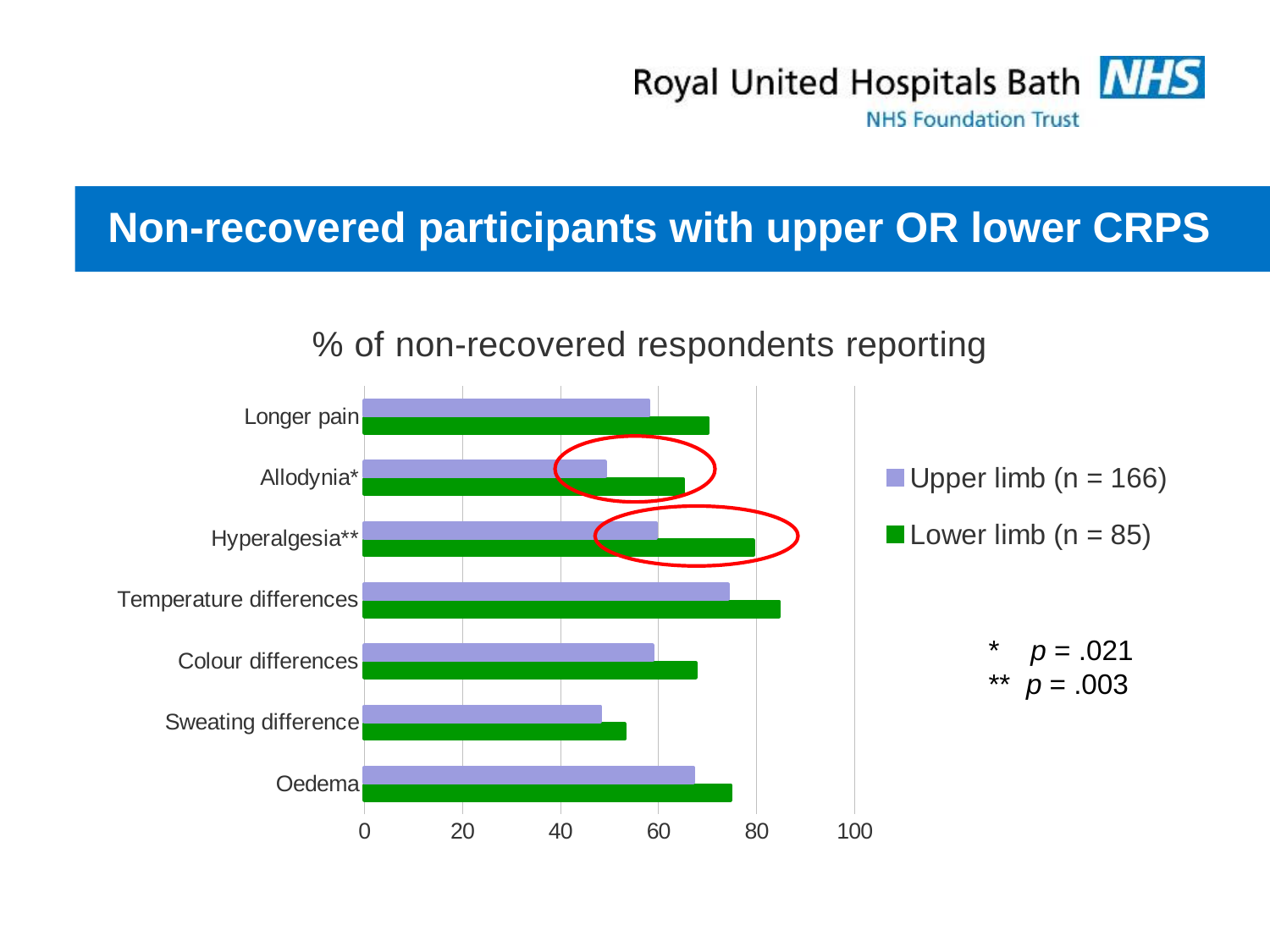
Is the Upper limb (n = 166) value for Allodynia* greater or less than 60? less What kind of chart is shown on the slide? Bar chart Is the Lower limb (n = 85) value for Temperature differences greater or less than 80? greater How many series does the legend list? 2 How many categories are plotted on the chart? 7 For the Upper limb (n = 166) series, which is larger, Oedema or Sweating difference? Oedema Which category has the highest value for the Lower limb (n = 85) series? Temperature differences Which series is shown in green in the legend? Lower limb (n = 85) For Hyperalgesia**, which series has the larger value, Upper limb (n = 166) or Lower limb (n = 85)? Lower limb (n = 85) Which category has the lowest value for the Lower limb (n = 85) series? Sweating difference What is the title of the chart? % of non-recovered respondents reporting Which category has the highest value for the Upper limb (n = 166) series? Temperature differences